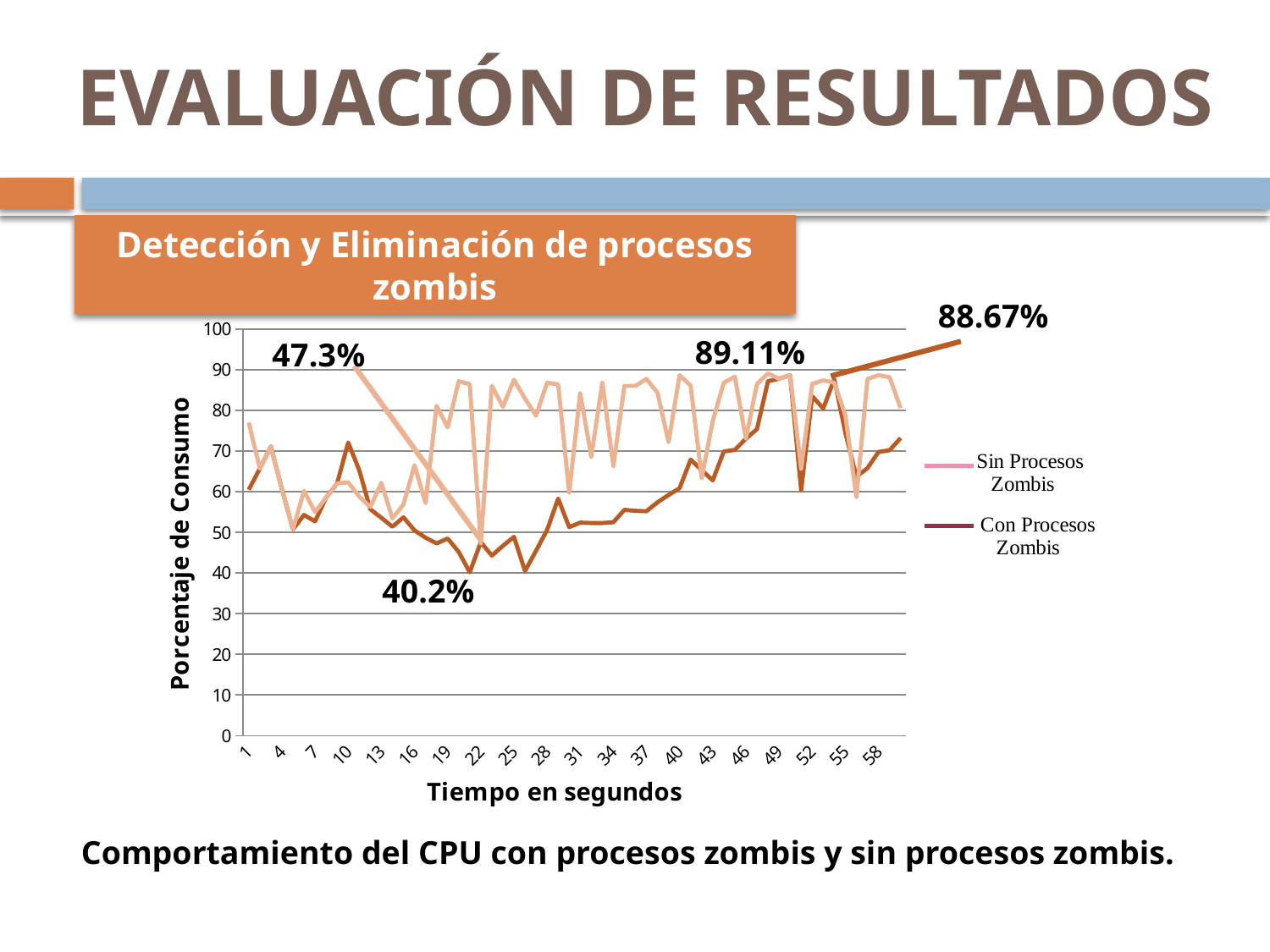
Is the value for Con Procesos Zombis at time 1 greater or less than 70? less Is the value for Sin Procesos Zombis at time 1 greater or less than 70? greater What is the lowest percentage value annotated on the chart? 40.2% At time 1, which series has the higher value, Sin Procesos Zombis or Con Procesos Zombis? Sin Procesos Zombis What is the highest percentage value annotated on the chart? 89.11% What are the two series named in the legend? Sin Procesos Zombis and Con Procesos Zombis Does the Con Procesos Zombis line generally rise or fall between time 28 and time 58? rise What is the title of the x axis? Tiempo en segundos Is the value for Con Procesos Zombis at time 49 greater or less than 80? greater What kind of chart is shown on the slide? line chart How many series does the legend list? 2